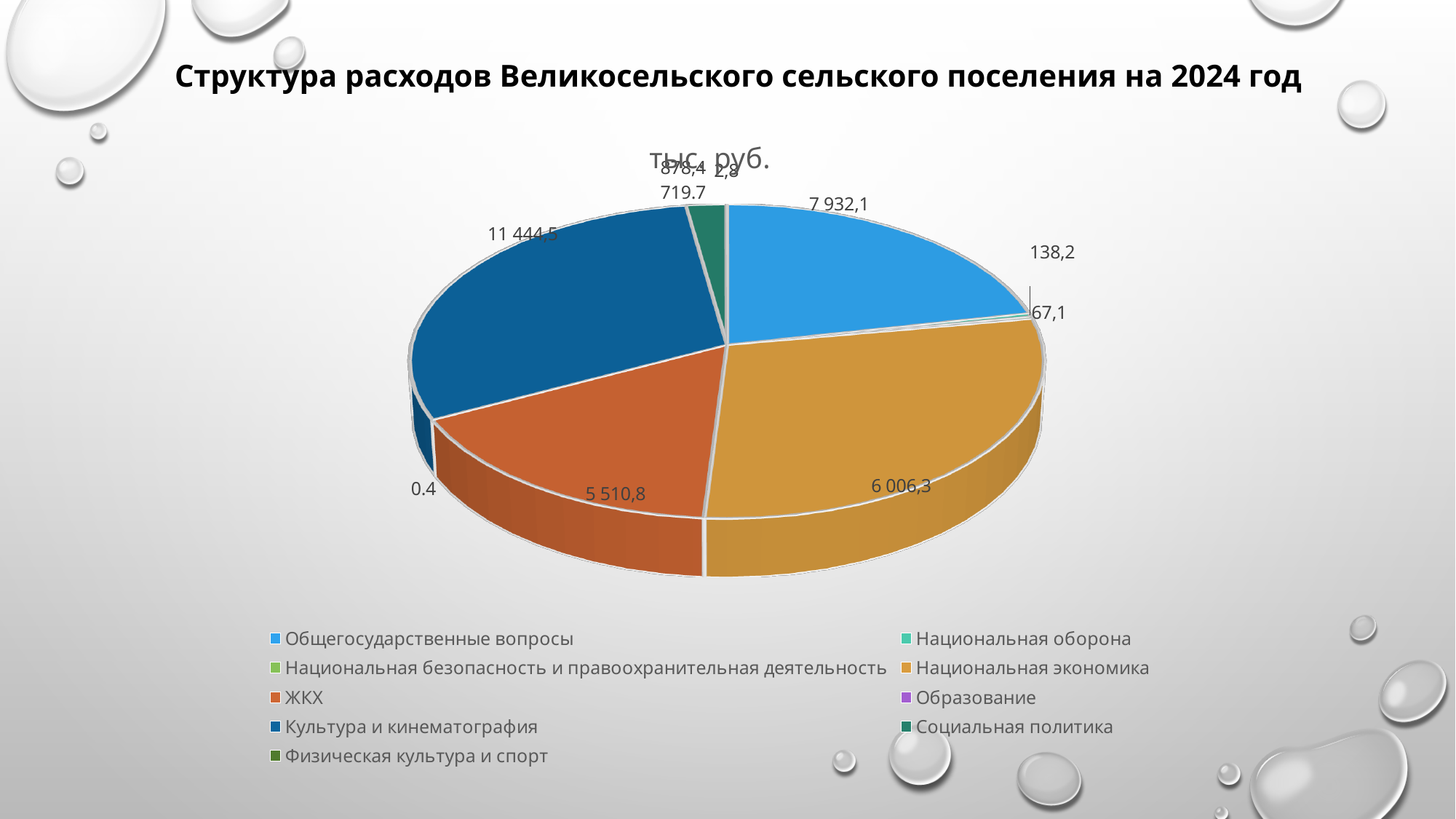
What is the value for Национальная экономика? 6 006,3 What is the difference between the values for Культура и кинематография and Общегосударственные вопросы? 3 512,4 What is the title shown above the pie chart? тыс. руб. Which category has the smallest slice of the pie? Образование How many categories does the legend of the pie chart list? 9 Which is larger, the value for Национальная экономика or the value for ЖКХ? Национальная экономика What is the value for ЖКХ? 5 510,8 What is the value for Национальная оборона? 138,2 What is the value for Культура и кинематография? 11 444,5 What is the value for Общегосударственные вопросы? 7 932,1 What kind of chart is shown on the slide? pie chart Which category has the largest slice of the pie? Культура и кинематография